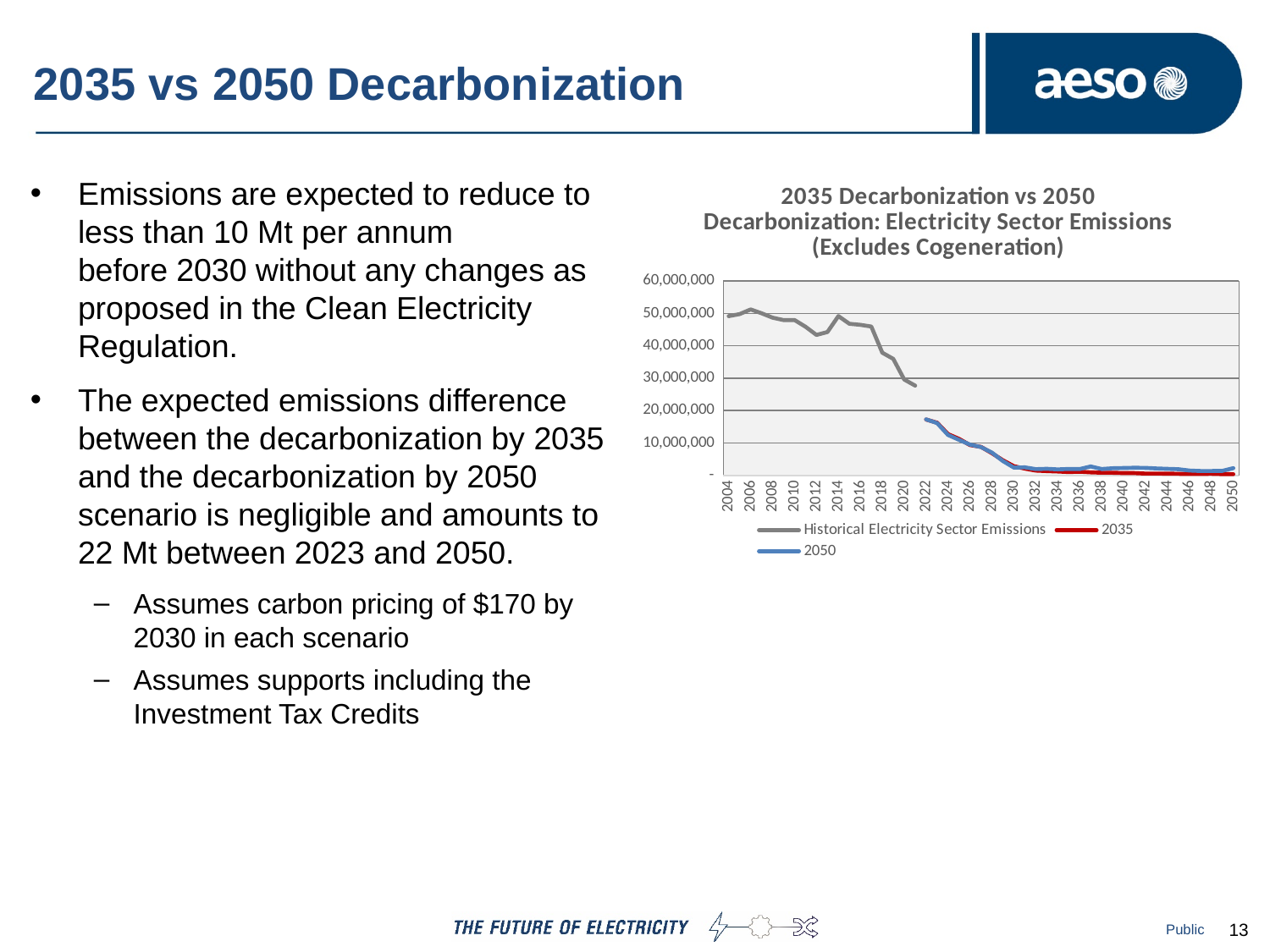
Do the Historical Electricity Sector Emissions generally rise or fall from 2004 to 2021? Fall Is the value of the 2050 series in 2022 greater or less than 20,000,000? less Is the value of the 2035 series in 2030 greater or less than 10,000,000? less Is the value of Historical Electricity Sector Emissions in 2014 greater or less than 40,000,000? greater How many series does the chart legend list? 3 What is the title of the chart? 2035 Decarbonization vs 2050 Decarbonization: Electricity Sector Emissions (Excludes Cogeneration) What kind of chart is shown on the slide? Line chart Does the 2035 series rise or fall from 2022 to 2050? Fall Which series is drawn in red on the chart? 2035